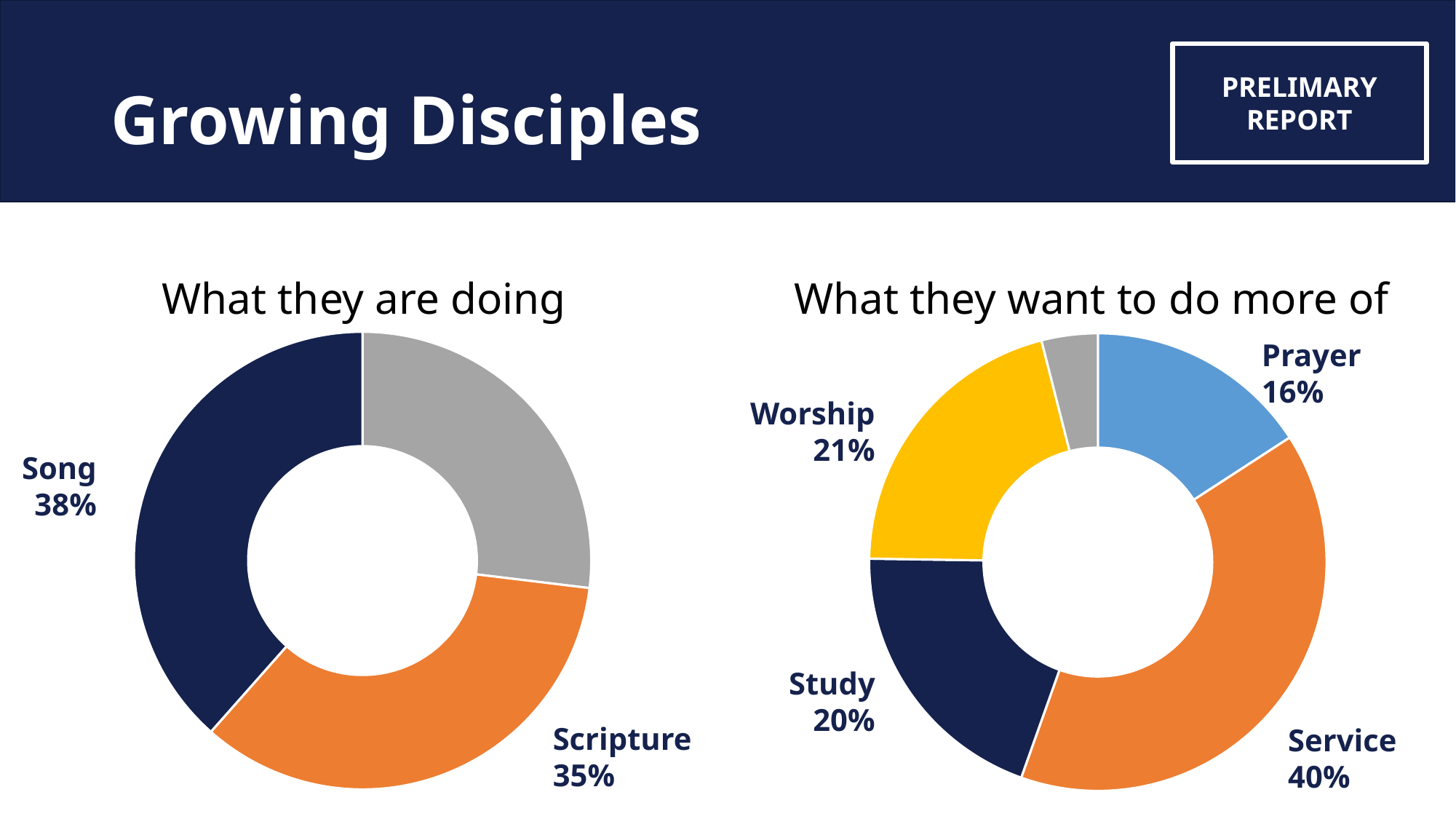
In the 'What they want to do more of' chart, what is the difference between Worship and Study? 1% In the 'What they are doing' chart, which is larger, Song or Scripture? Song In the 'What they are doing' chart, what percentage is shown for Song? 38% What kind of chart is used on the left side of the slide? Donut (pie) chart In the 'What they want to do more of' chart, which labeled category has the highest percentage? Service How many slices does the 'What they want to do more of' chart have? 5 How many slices does the 'What they are doing' chart have? 3 In the 'What they are doing' chart, what percentage is shown for Scripture? 35% In the 'What they want to do more of' chart, what percentage is shown for Service? 40% In the 'What they want to do more of' chart, what percentage is shown for Worship? 21% In the 'What they want to do more of' chart, what percentage is shown for Prayer? 16% In the 'What they want to do more of' chart, what is the difference between Service and Prayer? 24%